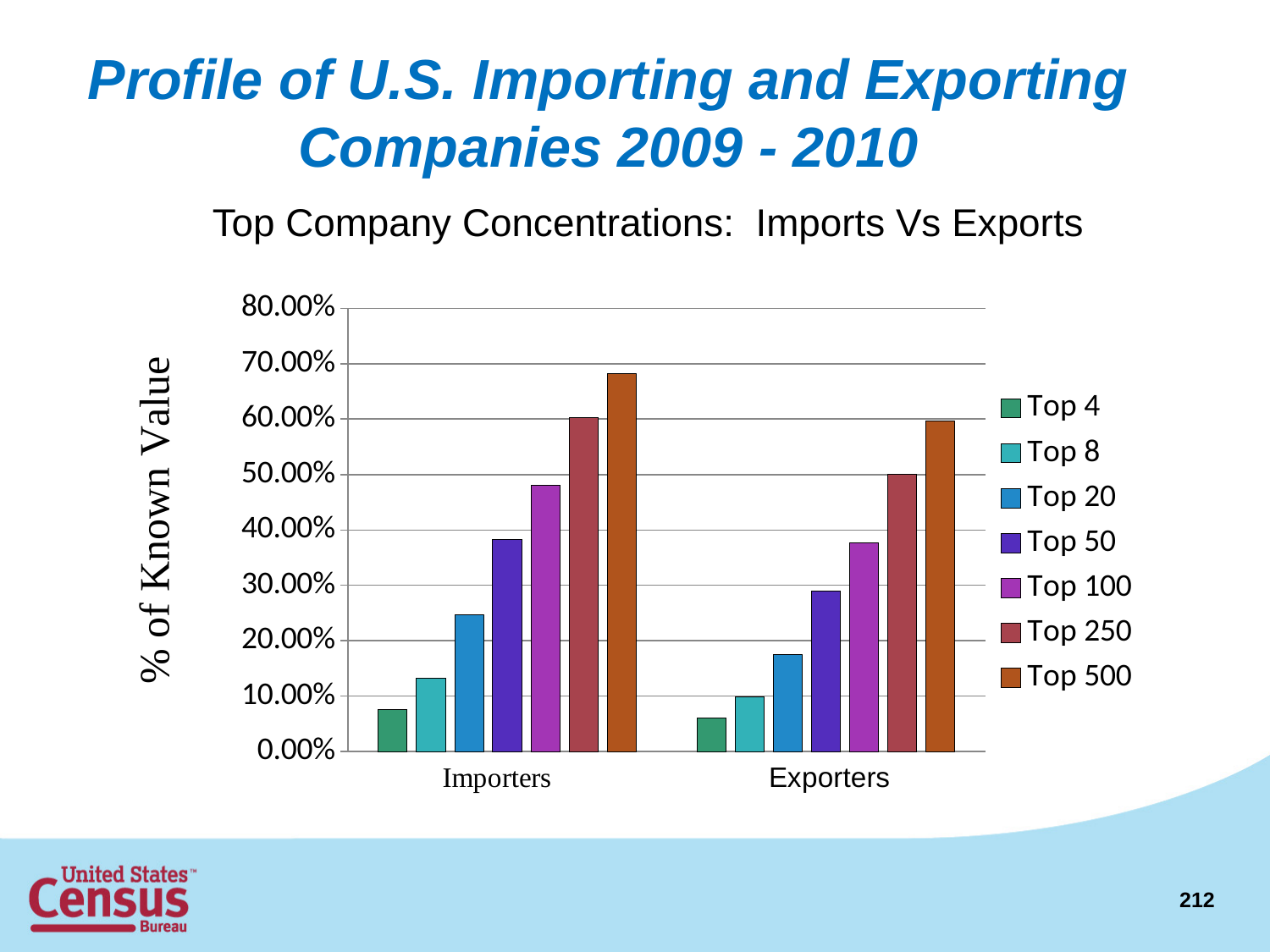
Which series has the tallest bar in the Importers category? Top 500 What is the label on the vertical axis of the chart? % of Known Value Which is larger, the Top 250 value for Importers or the Top 250 value for Exporters? Importers Which series has the shortest bar in the Exporters category? Top 4 How many series does the legend list? 7 Is the Top 20 value for Exporters greater or less than 20.00%? less Is the Top 500 value for Importers greater or less than 60.00%? greater Which is larger, the Top 500 value for Importers or the Top 500 value for Exporters? Importers Is the Top 20 value for Importers greater or less than 20.00%? greater What kind of chart is shown on the slide? bar chart How many categories are shown on the x axis? 2